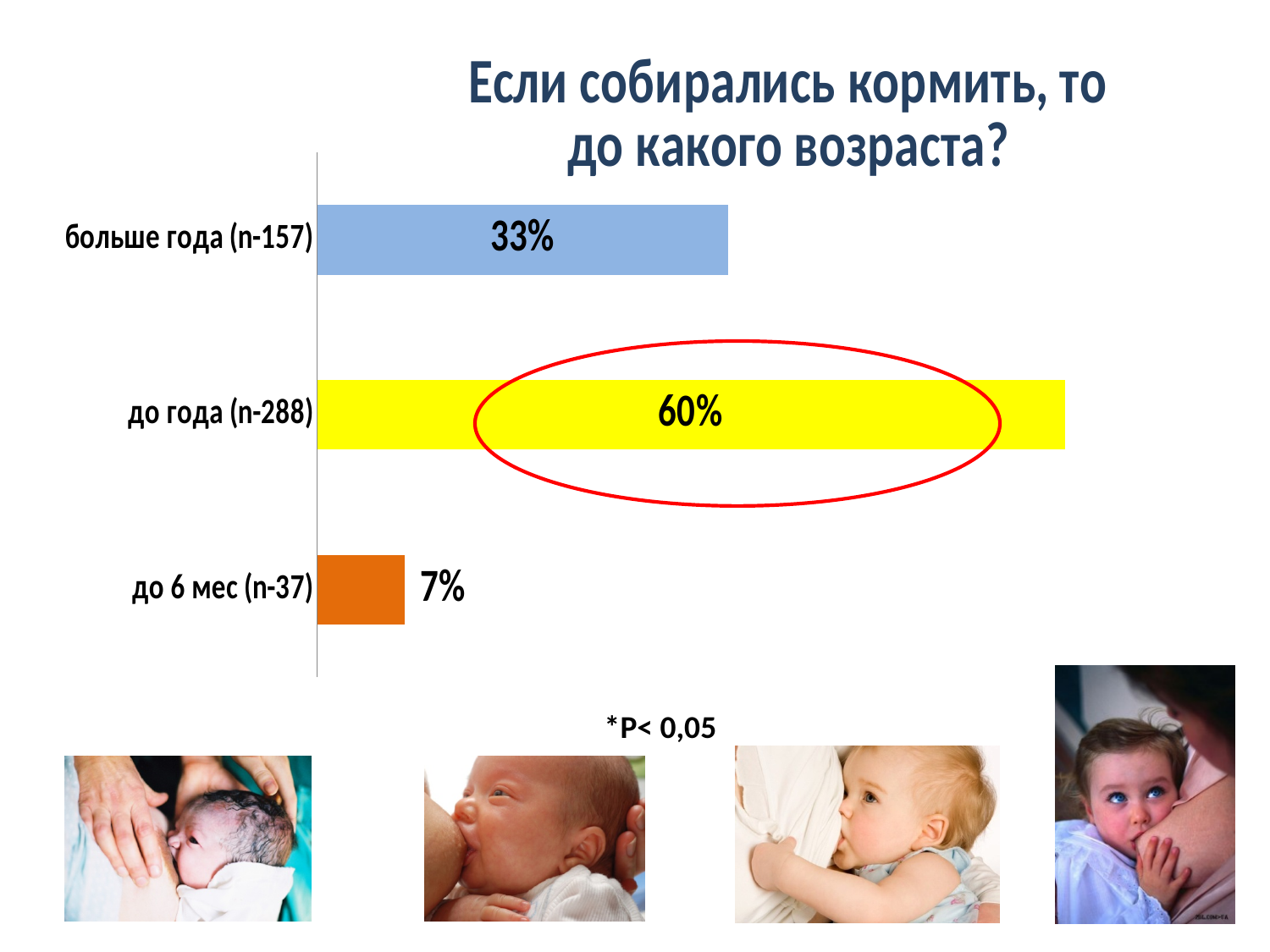
What percentage is shown for the category "до 6 мес (n-37)"? 7% What is the difference between the values for "до года (n-288)" and "больше года (n-157)"? 27% What is the title of the chart? Если собирались кормить, то до какого возраста? What percentage is shown for the category "больше года (n-157)"? 33% Which category has the highest value? до года (n-288) What kind of chart is shown on the slide? bar chart Which category's bar is highlighted with a red ellipse? до года (n-288) Which is larger: the value for "больше года (n-157)" or the value for "до 6 мес (n-37)"? больше года (n-157) What is the difference between the values for "больше года (n-157)" and "до 6 мес (n-37)"? 26% Which category has the lowest value? до 6 мес (n-37) How many categories are shown in the chart? 3 What percentage is shown for the category "до года (n-288)"? 60%